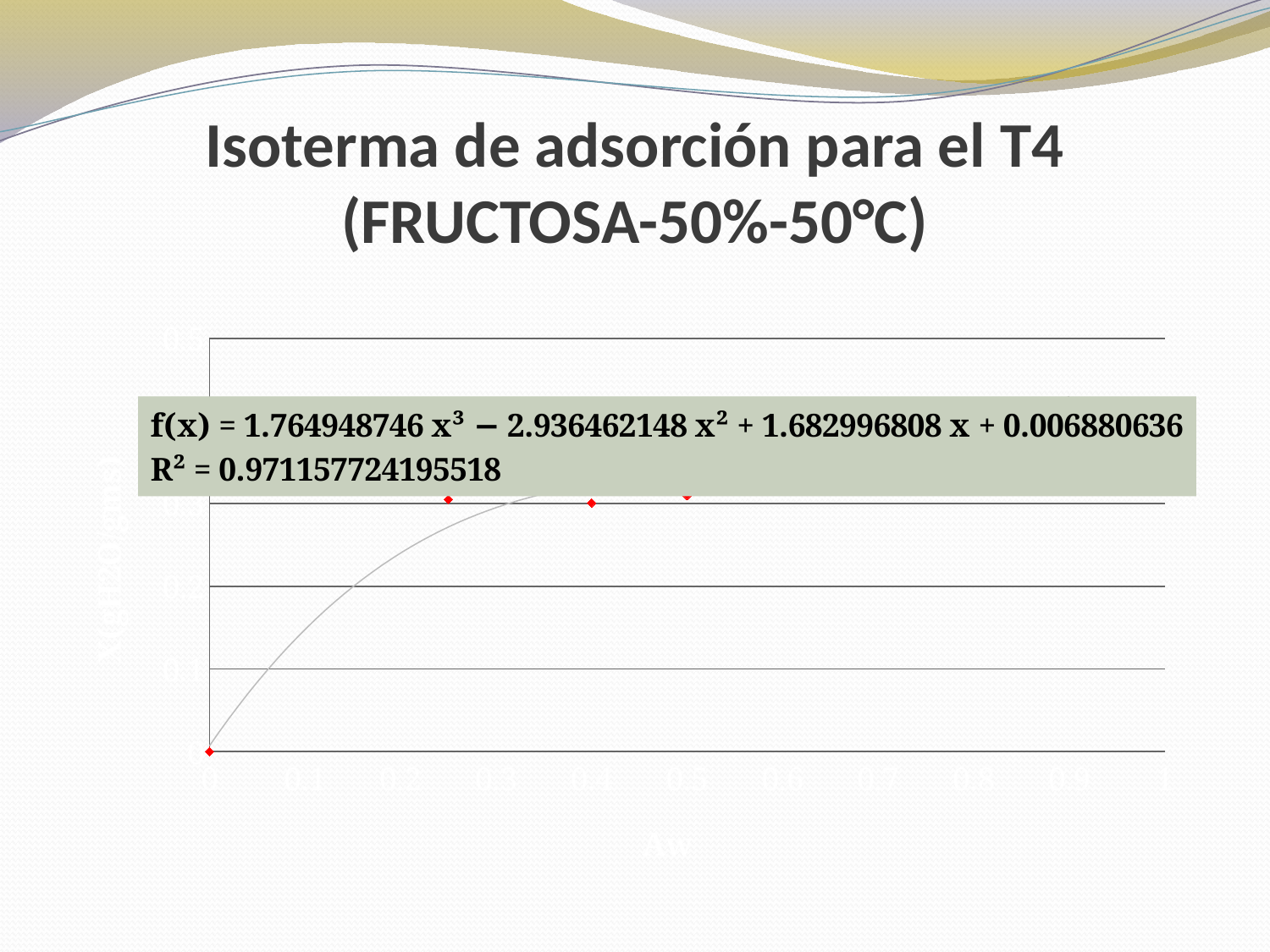
What is the R² value shown on the chart? 0.971157724195518 What is the highest value shown on the y axis? 0.5 Is the value for the data point at Aw = 0 greater or less than 0.1? less What is the title of the slide containing the chart? Isoterma de adsorción para el T4 (FRUCTOSA-50%-50°C) What is the coefficient of x³ in the fitted equation shown on the chart? 1.764948746 What kind of chart is shown on the slide? Scatter chart with a fitted trendline Does the fitted curve rise or fall as Aw increases from 0 to about 0.4? Rises Which data point has the lowest value, the one at Aw = 0 or the one at Aw = 0.5? Aw = 0 Is the value for the data point at Aw = 0.4 greater or less than 0.2? greater What is the constant term in the fitted equation shown on the chart? 0.006880636 What is the label of the x axis? Aw What is the coefficient of x² in the fitted equation shown on the chart? −2.936462148